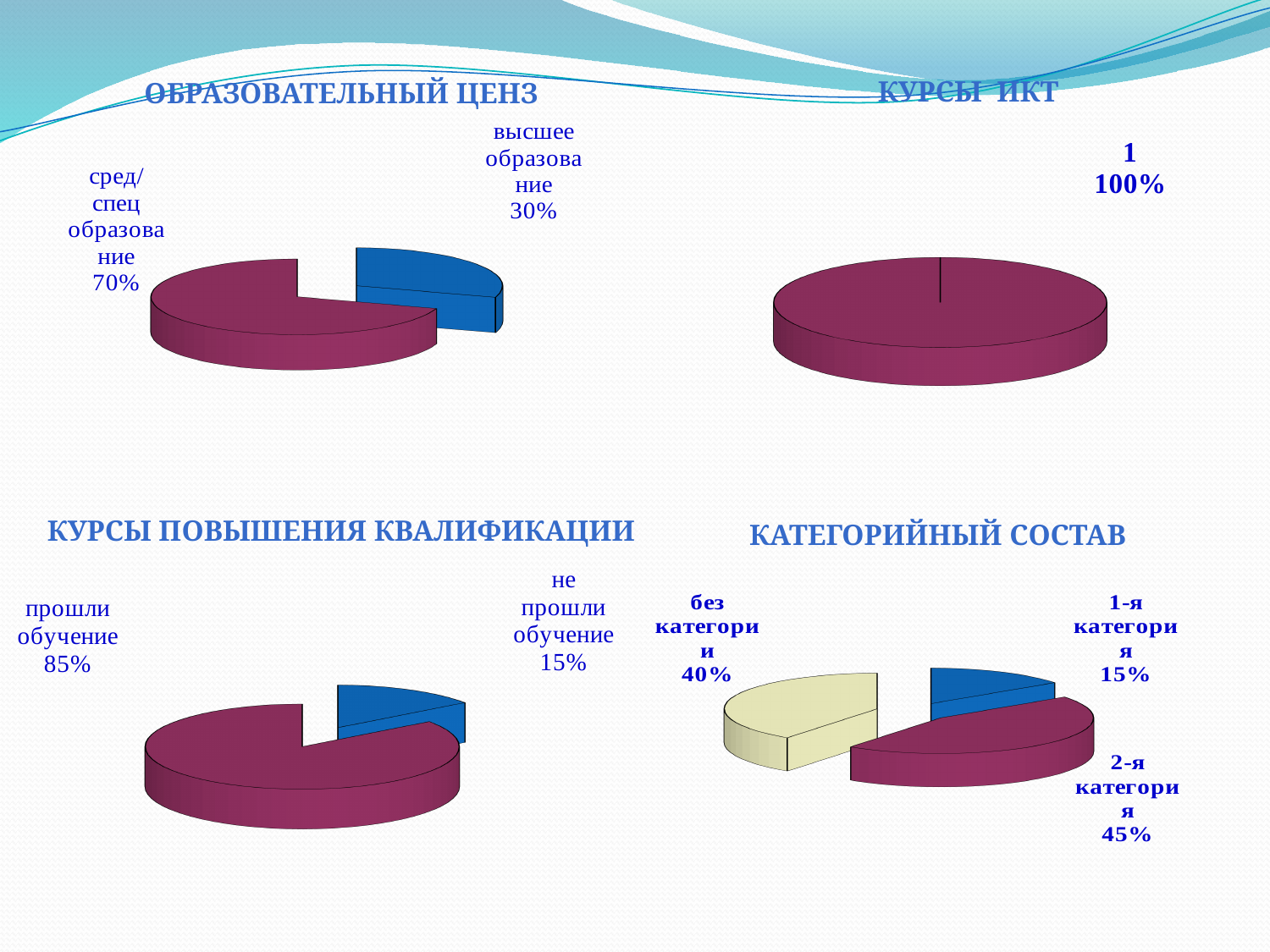
In the 'КАТЕГОРИЙНЫЙ СОСТАВ' chart, which category has the largest share? 2-я категория In the 'КАТЕГОРИЙНЫЙ СОСТАВ' chart, what share is labelled for 'без категории'? 40% In the 'КАТЕГОРИЙНЫЙ СОСТАВ' chart, which category has the smallest share? 1-я категория In the 'ОБРАЗОВАТЕЛЬНЫЙ ЦЕНЗ' chart, what share is labelled for 'высшее образование'? 30% In the 'КУРСЫ ИКТ' chart, what percentage is shown for the single slice? 100% In the 'ОБРАЗОВАТЕЛЬНЫЙ ЦЕНЗ' chart, what is the difference between the 'сред/спец образование' and 'высшее образование' shares? 40% What kind of chart is used under the title 'КУРСЫ ИКТ'? Pie chart In the 'КУРСЫ ПОВЫШЕНИЯ КВАЛИФИКАЦИИ' chart, what share is labelled for 'прошли обучение'? 85% In the 'КУРСЫ ПОВЫШЕНИЯ КВАЛИФИКАЦИИ' chart, what share is labelled for 'не прошли обучение'? 15% In the 'ОБРАЗОВАТЕЛЬНЫЙ ЦЕНЗ' chart, what share is labelled for 'сред/спец образование'? 70% In the 'КУРСЫ ПОВЫШЕНИЯ КВАЛИФИКАЦИИ' chart, which slice is larger: 'прошли обучение' or 'не прошли обучение'? прошли обучение How many slices does the 'КАТЕГОРИЙНЫЙ СОСТАВ' chart have? 3